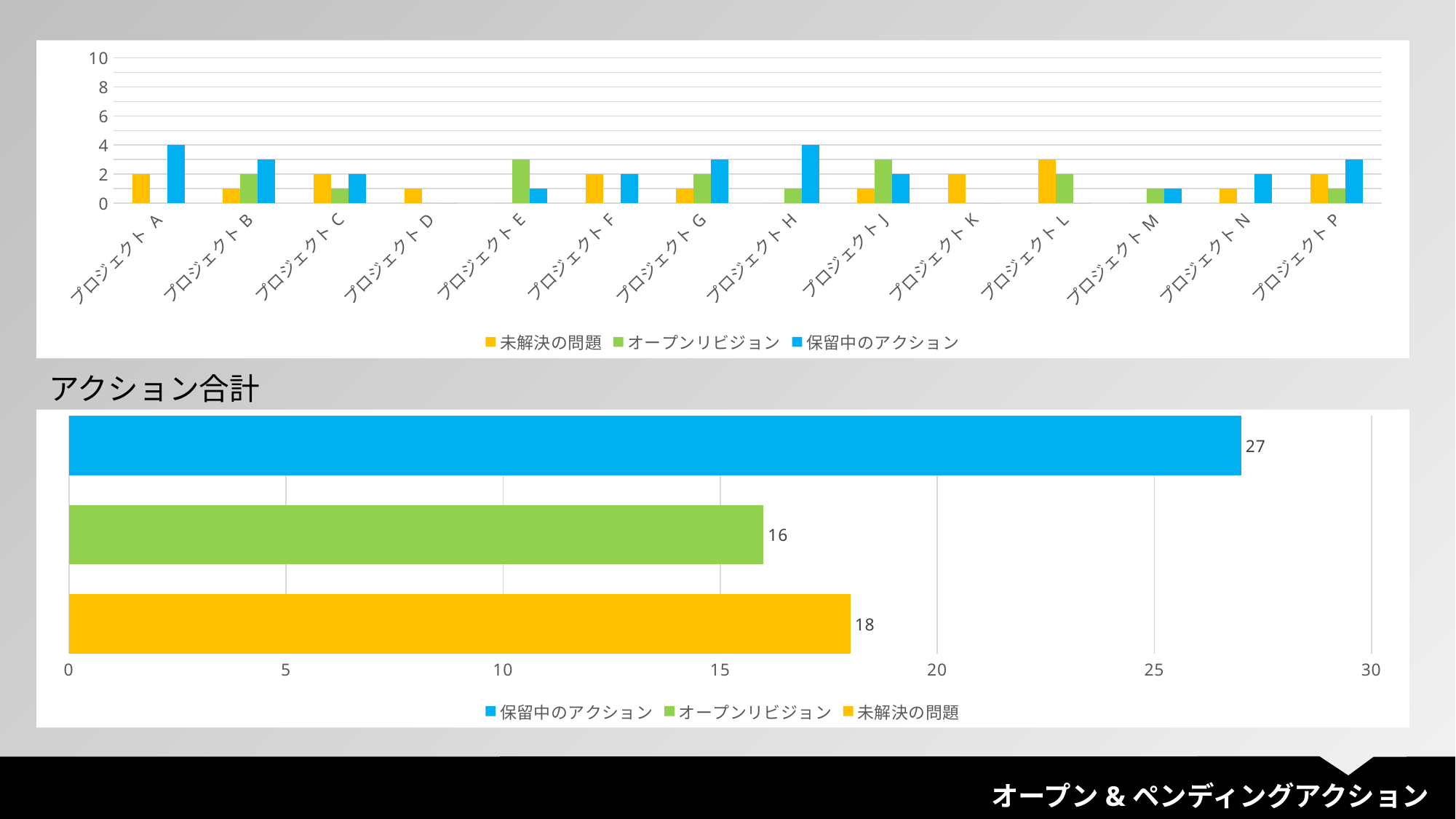
In the top chart, how many series does the legend list? 3 In the bottom chart titled アクション合計, what is the difference between 保留中のアクション and 未解決の問題? 9 In the bottom chart titled アクション合計, which category has the highest value? 保留中のアクション In the bottom chart titled アクション合計, what is the value for 未解決の問題? 18 In the top chart, what is the value of 保留中のアクション for プロジェクト A? 4 What kind of chart is the bottom chart titled アクション合計? bar chart In the bottom chart titled アクション合計, which category has the lowest value? オープンリビジョン In the bottom chart titled アクション合計, what is the value for 保留中のアクション? 27 In the bottom chart titled アクション合計, what is the value for オープンリビジョン? 16 In the bottom chart titled アクション合計, is the value for 保留中のアクション greater or less than 25? greater In the bottom chart titled アクション合計, which is larger: 未解決の問題 or オープンリビジョン? 未解決の問題 In the top chart, how many projects are shown on the x axis? 14